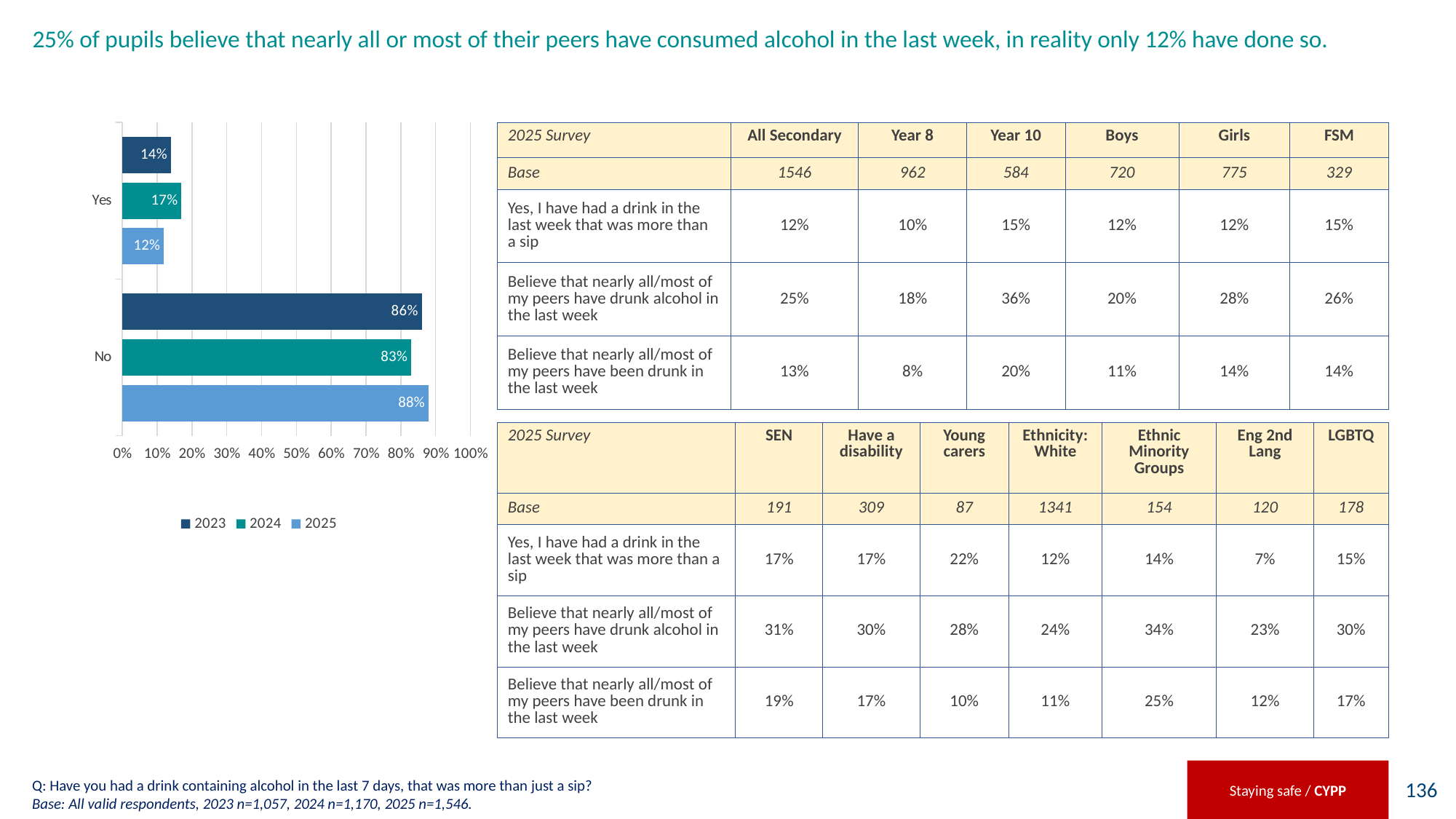
Is the 'Yes' value for 2023 larger or smaller than the 'Yes' value for 2025 in the bar chart? larger What is the value for 'Yes' in 2024 in the bar chart? 17% What is the value for 'Yes' in 2025 in the bar chart? 12% Is the value for 'No' in 2025 greater or less than 80%? greater How many series does the legend of the bar chart list? 3 How many categories are shown on the vertical axis of the bar chart? 2 What is the value for 'No' in 2023 in the bar chart? 86% Which year has the highest value for 'Yes' in the bar chart? 2024 What are the legend entries of the bar chart? 2023, 2024, 2025 What is the difference between the 'No' values for 2025 and 2024 in the bar chart? 5% What kind of chart is shown on the left of the slide? bar chart Which year has the lowest value for 'No' in the bar chart? 2024